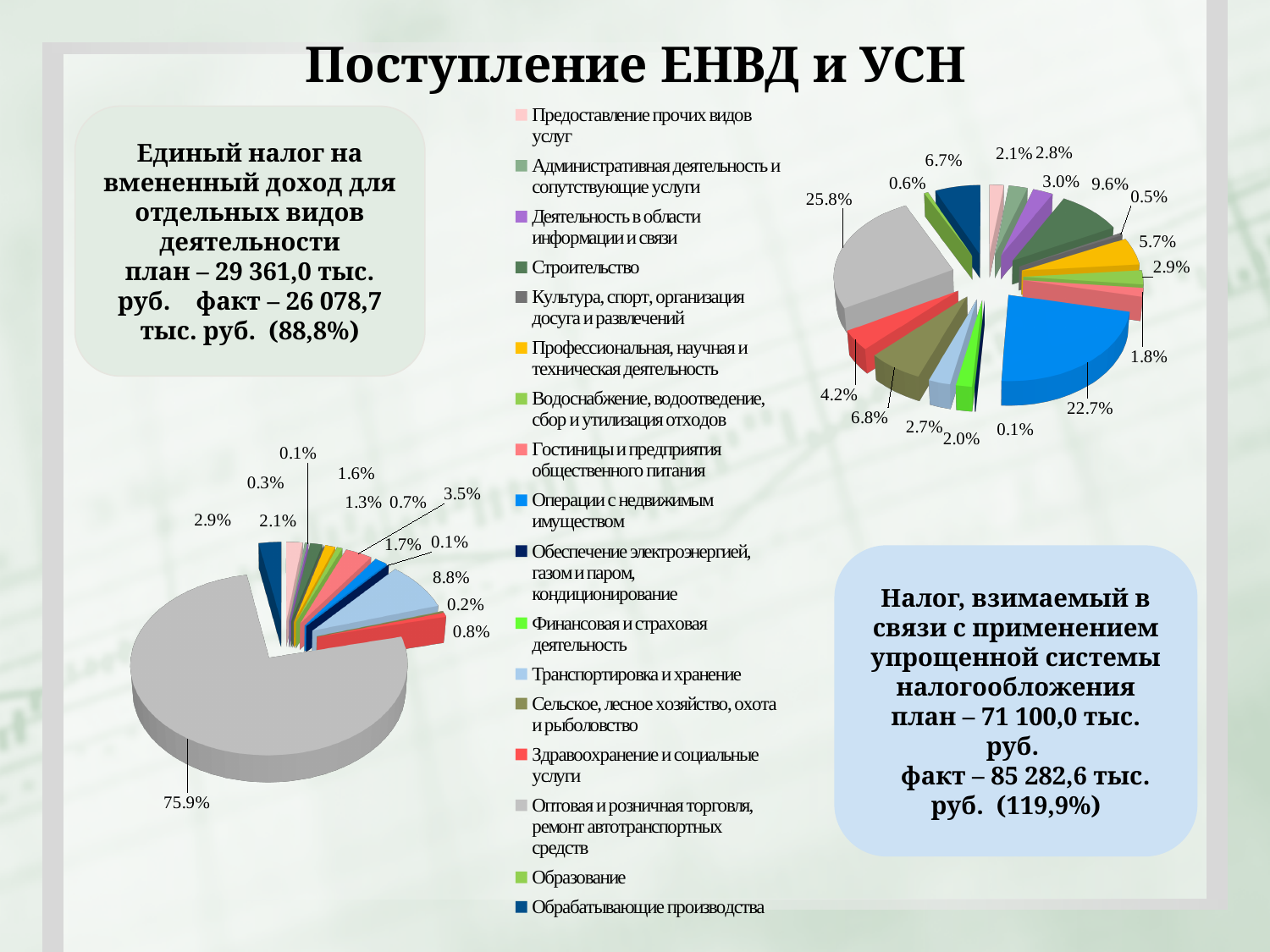
In the right pie chart, what share does 'Оптовая и розничная торговля, ремонт автотранспортных средств' (grey slice) have? 25.8% Which chart has the larger largest slice, the left pie chart or the right pie chart? The left pie chart How many pie charts are shown on the slide? 2 In the left pie chart, what is the value of the largest slice? 75.9% What is the title of the slide? Поступление ЕНВД и УСН In the right pie chart, what share does 'Операции с недвижимым имуществом' (blue slice) have? 22.7% In the left pie chart, what share does 'Оптовая и розничная торговля, ремонт автотранспортных средств' (grey slice) have? 75.9% In the right pie chart, what is the difference between the two largest slices, 25.8% and 22.7%? 3.1 percentage points How many categories does the shared legend list? 17 In the right pie chart, what is the value of the largest slice? 25.8% In the right pie chart, what is the smallest labelled slice value? 0.1% What kind of chart is the left chart on the slide? Pie chart